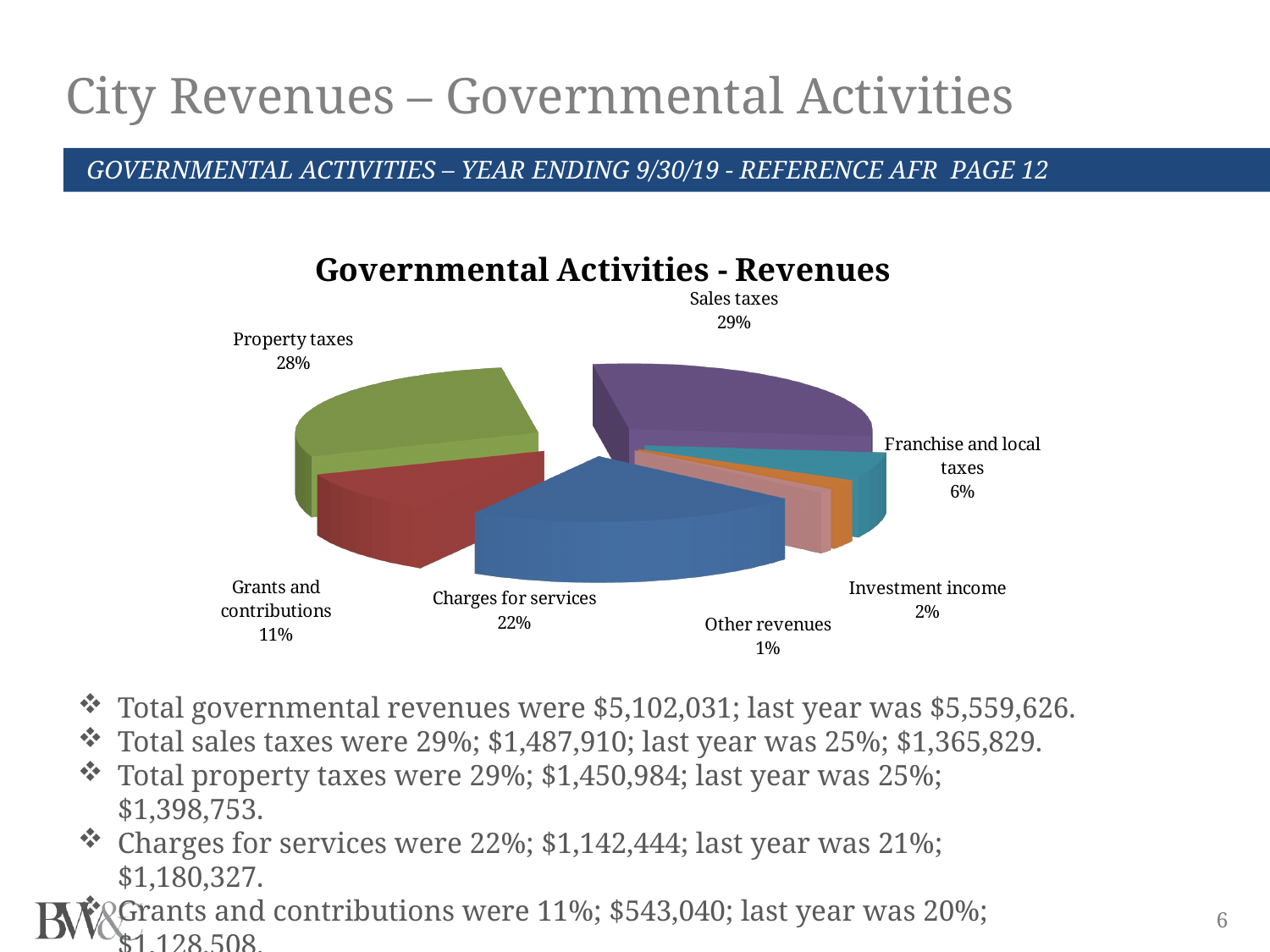
Which category has the smallest share of the pie? Other revenues How many categories are shown in the pie chart? 7 What share of the pie is Charges for services? 22% What share of the pie is Grants and contributions? 11% What is the title of the chart? Governmental Activities - Revenues What share of the pie is Investment income? 2% What share of the pie is Property taxes? 28% What share of the pie is Franchise and local taxes? 6% What share of the pie is Sales taxes? 29% What is the difference in percentage points between Charges for services and Grants and contributions? 11 Which category has the largest share of the pie? Sales taxes What kind of chart is shown on the slide? Pie chart